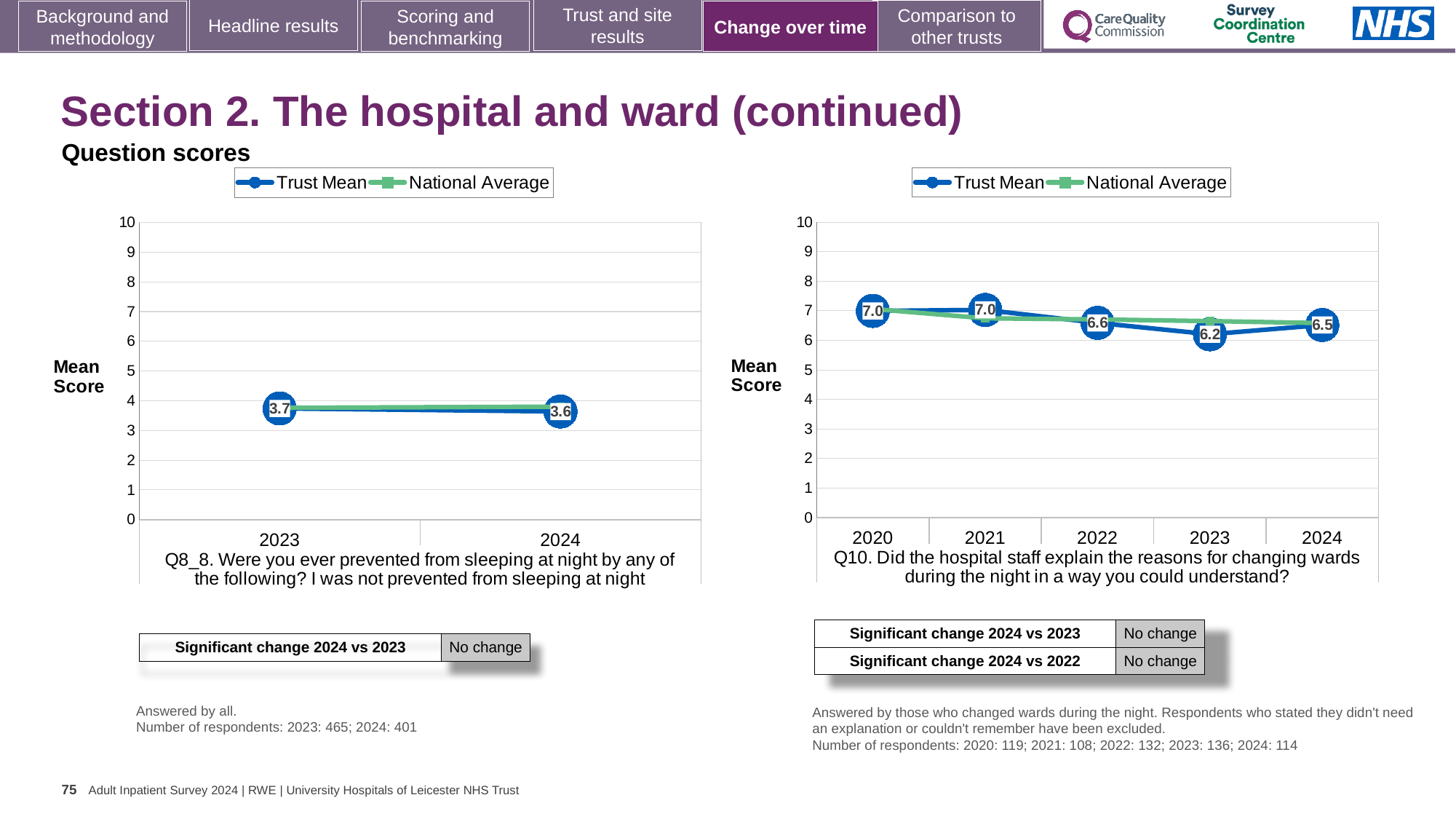
In the right chart (Q10), which year has the lowest Trust Mean score? 2023 In the right chart (Q10), what is the difference between the Trust Mean scores for 2021 and 2024? 0.5 In the left chart (Q8_8), what is the Trust Mean score for 2023? 3.7 In the right chart (Q10), what is the Trust Mean score for 2022? 6.6 What kind of chart is the right chart (Q10)? Line chart In the right chart (Q10), does the Trust Mean score rise or fall from 2021 to 2023? Fall How many series does the legend of the left chart (Q8_8) list? 2 In the right chart (Q10), is the National Average value for 2023 greater or less than 6? greater In the right chart (Q10), what is the Trust Mean score for 2023? 6.2 How many years are shown on the x axis of the right chart (Q10)? 5 In the right chart (Q10), is the Trust Mean score higher in 2022 or in 2023? 2022 In the left chart (Q8_8), what is the Trust Mean score for 2024? 3.6